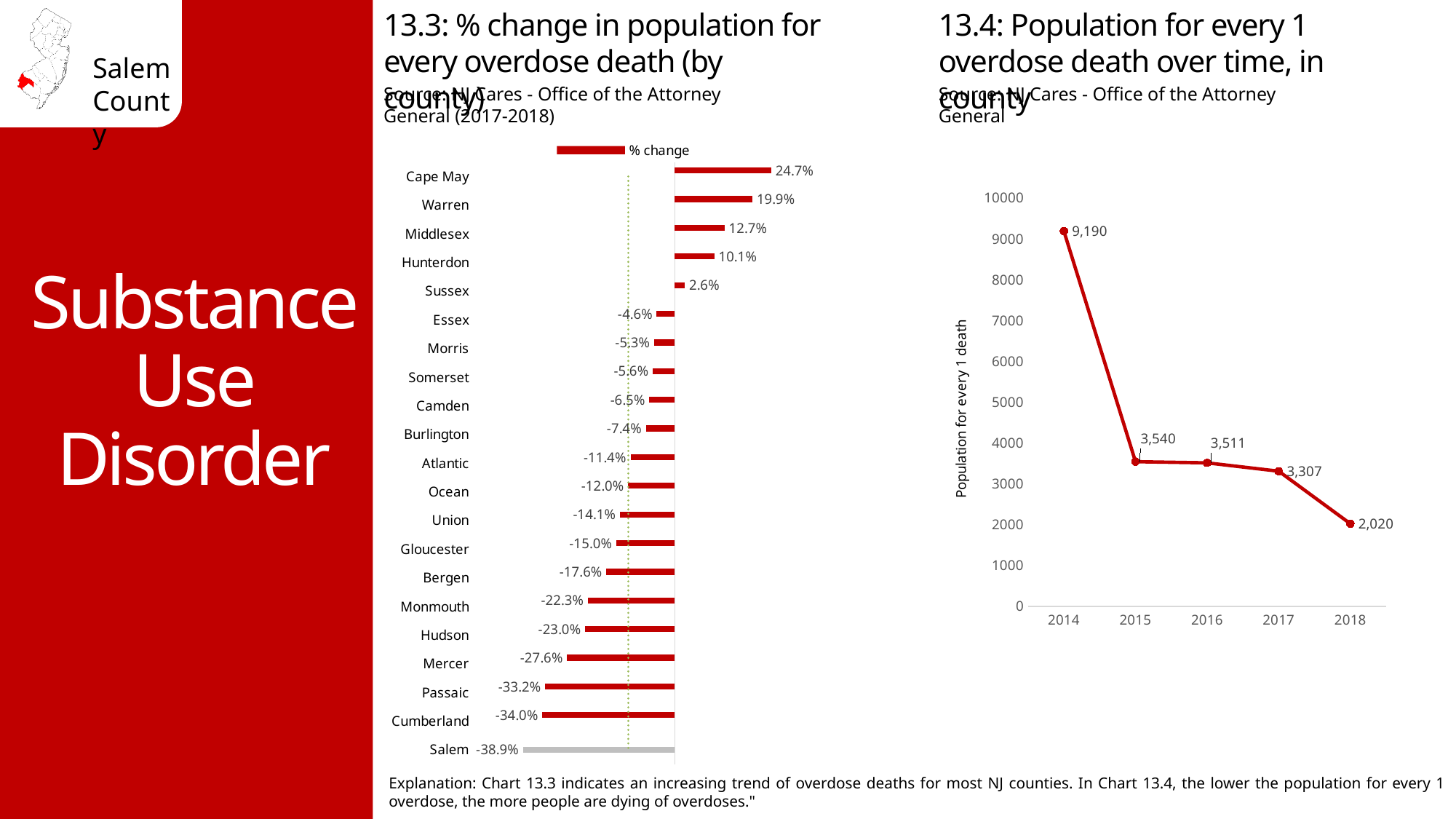
What kind of chart is chart 13.3? Bar chart In chart 13.3, what is the difference between the % change for Warren and Middlesex? 7.2 percentage points In chart 13.4, what is the population for every 1 overdose death in 2014? 9,190 In chart 13.3, what is the % change for Cape May? 24.7% In chart 13.3, how many counties are shown? 21 In chart 13.4, what is the population for every 1 overdose death in 2018? 2,020 In chart 13.3, which county has the highest % change? Cape May In chart 13.4, do the values rise or fall from 2014 to 2018? Fall In chart 13.3, which county has the lowest % change? Salem In chart 13.3, which has a larger % change, Hudson or Mercer? Hudson In chart 13.4, what is the difference between the 2015 and 2016 values? 29 In chart 13.3, what is the % change for Salem? -38.9%